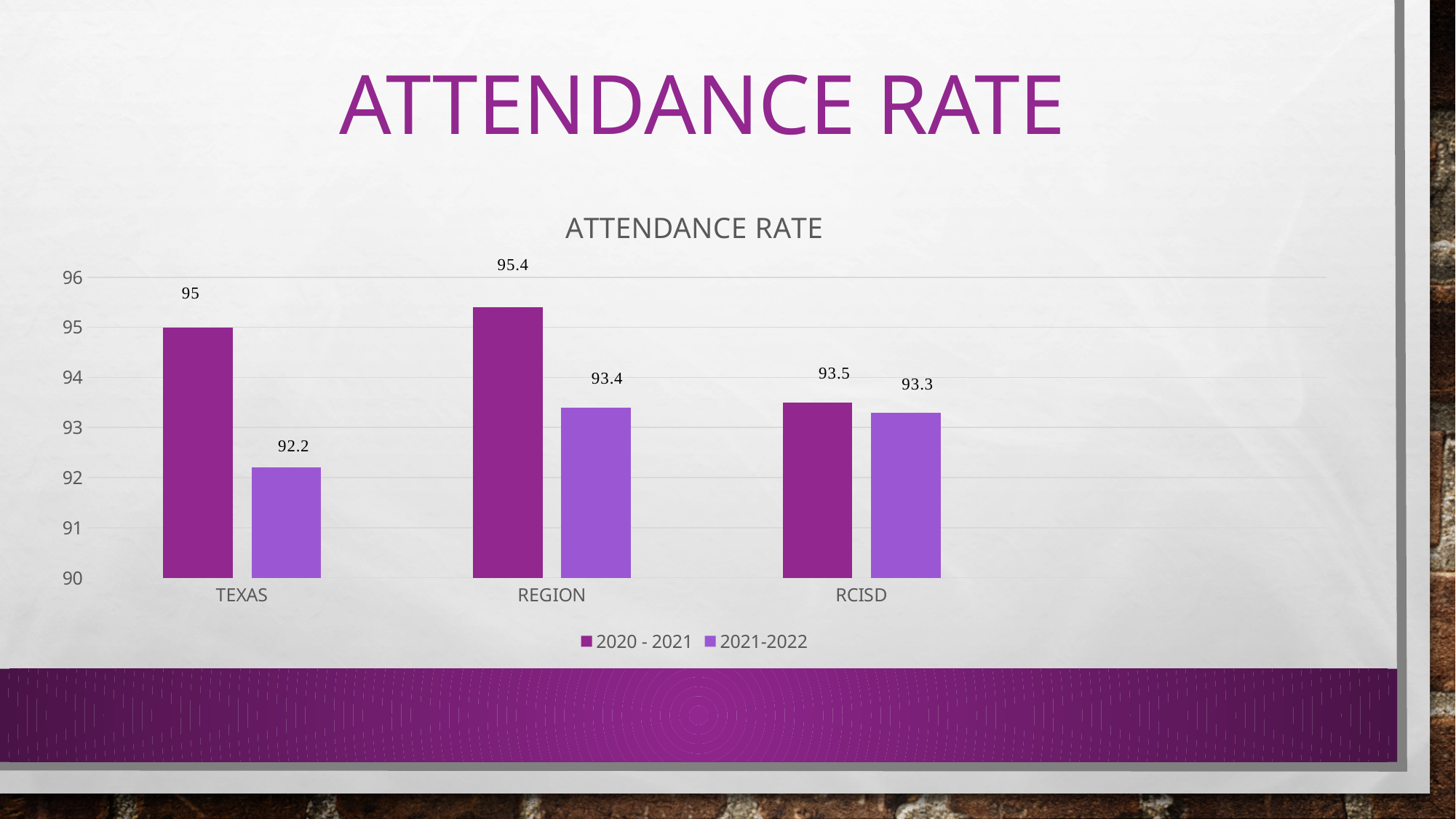
What kind of chart is shown on the slide? Bar chart What is the attendance rate for Region in 2021-2022? 93.4 How many series does the legend list? 2 Which category has the lowest attendance rate in 2021-2022? Texas What is the difference between the Texas attendance rate in 2020 - 2021 and in 2021-2022? 2.8 What is the difference between the Region and RCISD attendance rates in 2020 - 2021? 1.9 What is the attendance rate for RCISD in 2021-2022? 93.3 What is the title of the chart? ATTENDANCE RATE Which is larger: the 2021-2022 attendance rate for Region or for Texas? Region What is the attendance rate for Texas in 2020 - 2021? 95 Which category has the highest attendance rate in 2020 - 2021? Region How many categories are shown on the x axis? 3